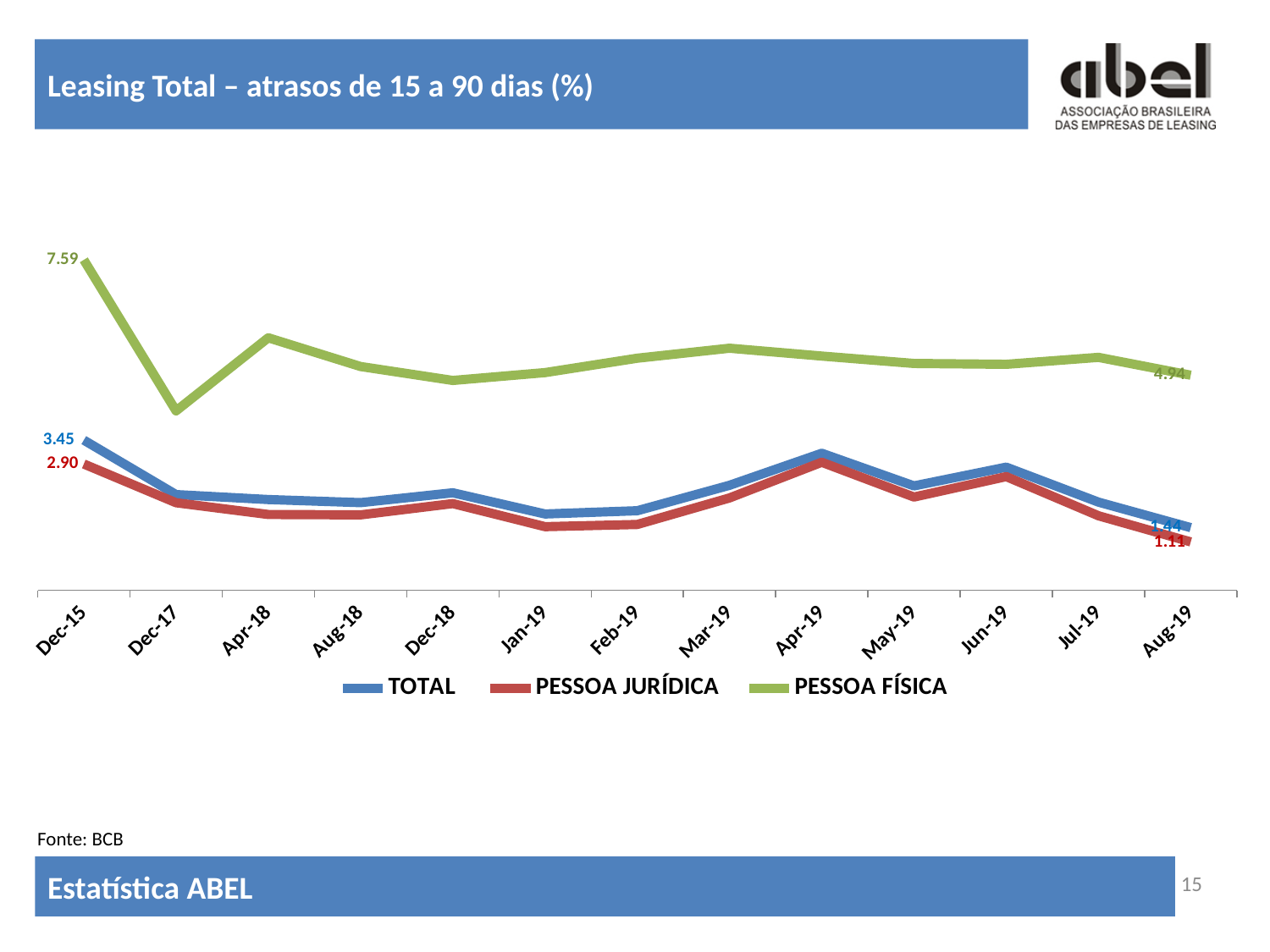
Which series has the highest value in Aug-19? PESSOA FÍSICA By how much did the PESSOA FÍSICA value fall from Dec-15 to Aug-19? 2.65 How many points are plotted along the x axis? 13 What is the difference between TOTAL and PESSOA JURÍDICA in Dec-15? 0.55 How many series does the legend list? 3 What is the value for PESSOA FÍSICA in Dec-15? 7.59 What type of chart is shown on the slide? line chart What is the value for PESSOA FÍSICA in Aug-19? 4.94 In which period is the PESSOA FÍSICA value lowest? Dec-17 What is the value for TOTAL in Dec-15? 3.45 What is the value for TOTAL in Aug-19? 1.44 What is the value for PESSOA JURÍDICA in Aug-19? 1.11